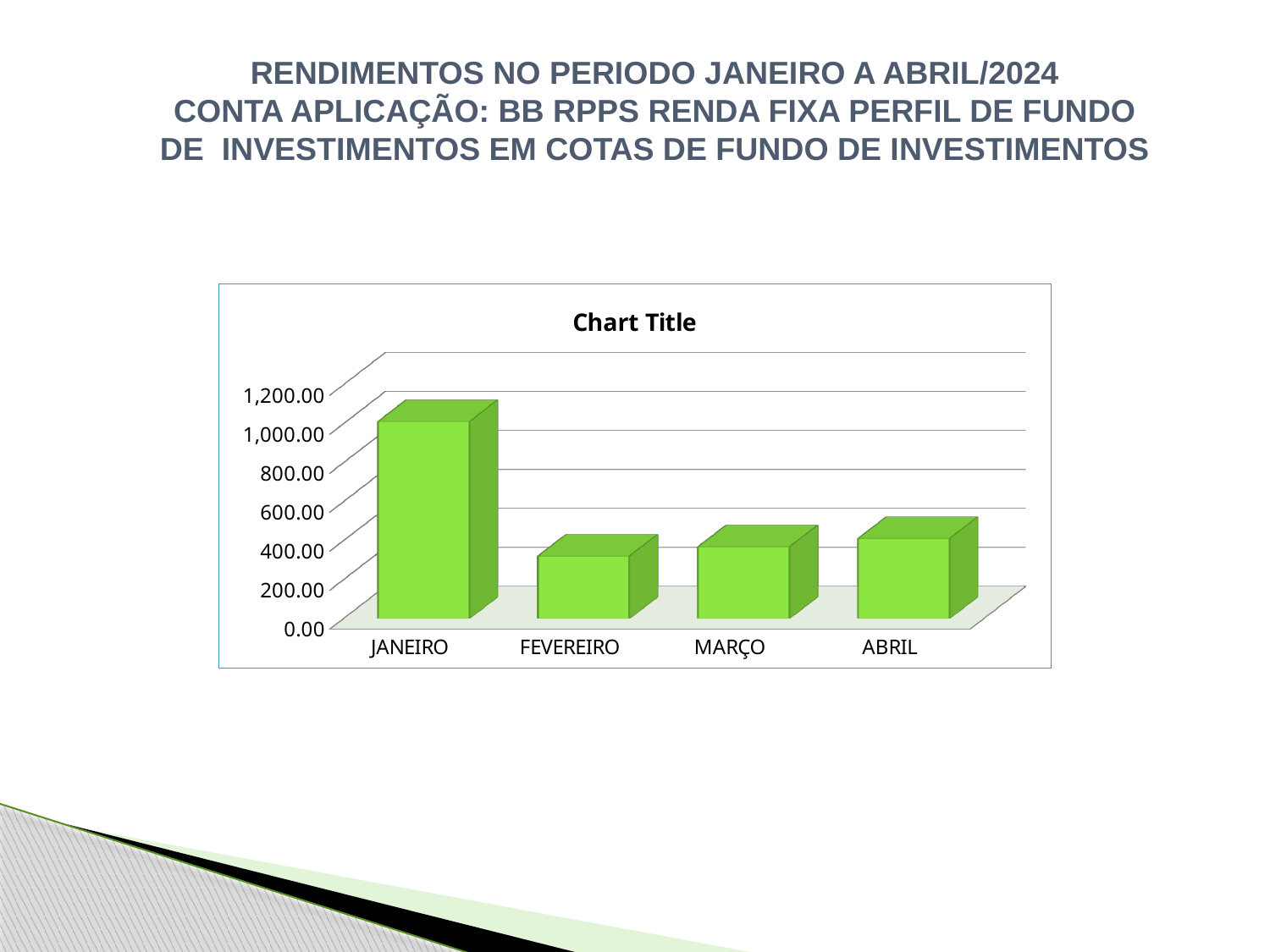
Is the value for ABRIL greater or less than 800? less Is the value for MARÇO greater or less than 600? less Does the value rise or fall from JANEIRO to FEVEREIRO? fall How many categories are shown on the x axis of the chart? 4 Is the value for FEVEREIRO greater or less than 600? less Which is larger, the value for JANEIRO or the value for FEVEREIRO? JANEIRO What is the title printed above the chart? Chart Title What colour are the bars in the chart? green Which category has the highest value in the chart? JANEIRO Which is larger, the value for JANEIRO or the value for ABRIL? JANEIRO What kind of chart is shown on the slide? bar chart